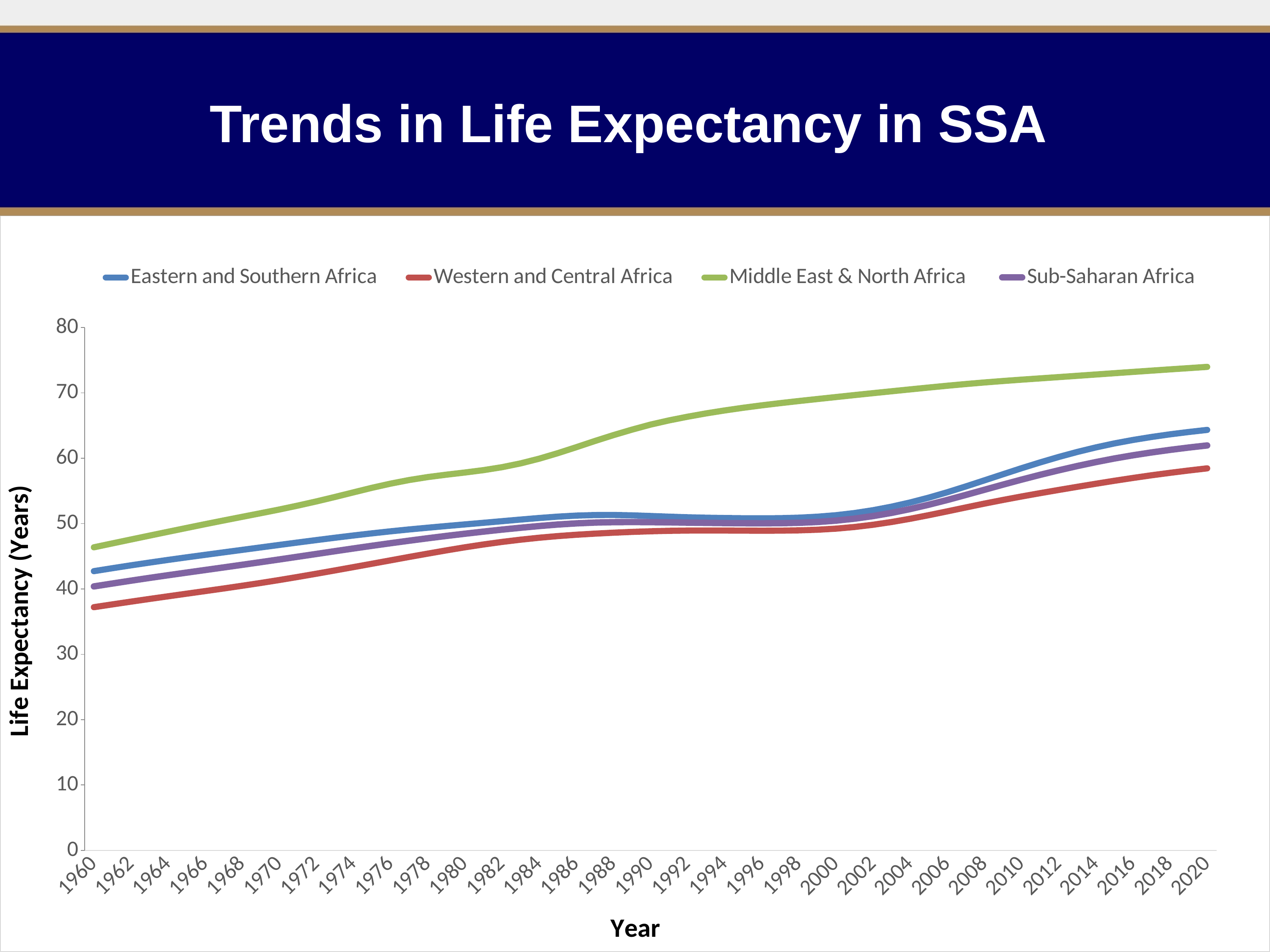
How many series does the legend list? 4 Is the value for Middle East & North Africa in 2020 greater or less than 70? greater What kind of chart is shown on the slide? line chart Does the Middle East & North Africa line rise or fall from 1960 to 2020? rise Which series has the lowest life expectancy in 1960? Western and Central Africa Which series has the highest life expectancy in 2020? Middle East & North Africa In 1980, which is higher: Middle East & North Africa or Eastern and Southern Africa? Middle East & North Africa Is the value for Western and Central Africa in 1960 greater or less than 40? less Is the value for Sub-Saharan Africa in 2020 greater or less than 60? greater What is the label on the vertical axis? Life Expectancy (Years) How many year labels are shown on the x axis? 31 Which series has the lowest life expectancy in 2020? Western and Central Africa